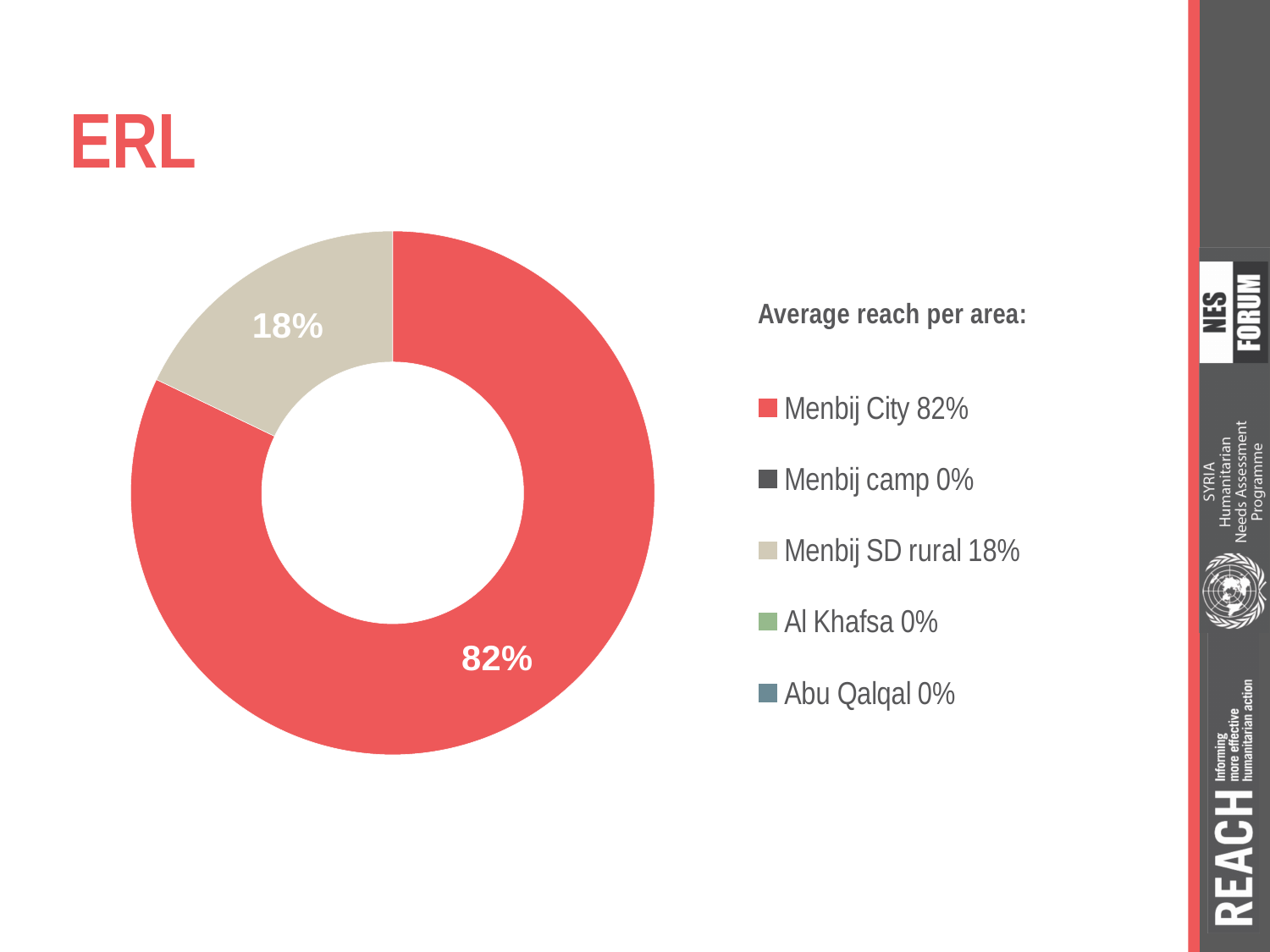
How many areas are listed in the legend? 5 What is the average reach for Menbij SD rural? 18% What kind of chart is shown on the slide? Doughnut chart What share of the chart does the Menbij City slice represent? 82% Which has a larger average reach, Menbij SD rural or Menbij camp? Menbij SD rural How many areas have an average reach of 0%? 3 Which area has the highest average reach? Menbij City What is the average reach for Abu Qalqal? 0% What is the average reach for Al Khafsa? 0% What colour is the Menbij City slice? Red What is the difference in average reach between Menbij City and Menbij SD rural? 64% What is the average reach for Menbij City? 82%